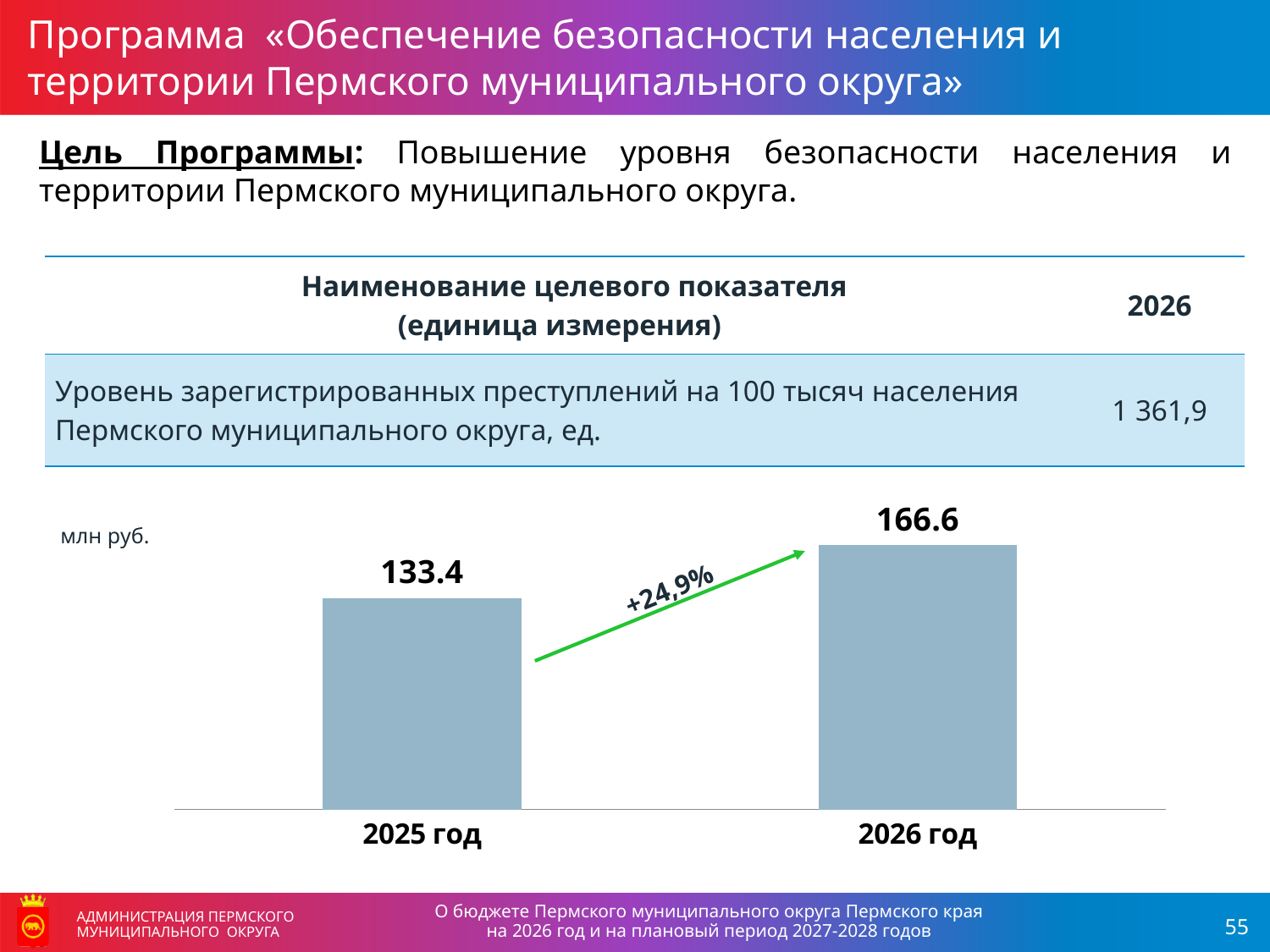
What kind of chart is shown on the slide? bar chart What percentage change is shown on the arrow between the two bars? +24,9% What is the value for 2026 год? 166.6 Which year has the lower value? 2025 год What unit is indicated for the chart values? млн руб. How many bars are shown in the chart? 2 Is the value for 2026 год larger or smaller than the value for 2025 год? larger Do the values rise or fall from 2025 год to 2026 год? rise What is the difference between the values for 2026 год and 2025 год? 33.2 What is the value for 2025 год? 133.4 Which year has the higher value? 2026 год